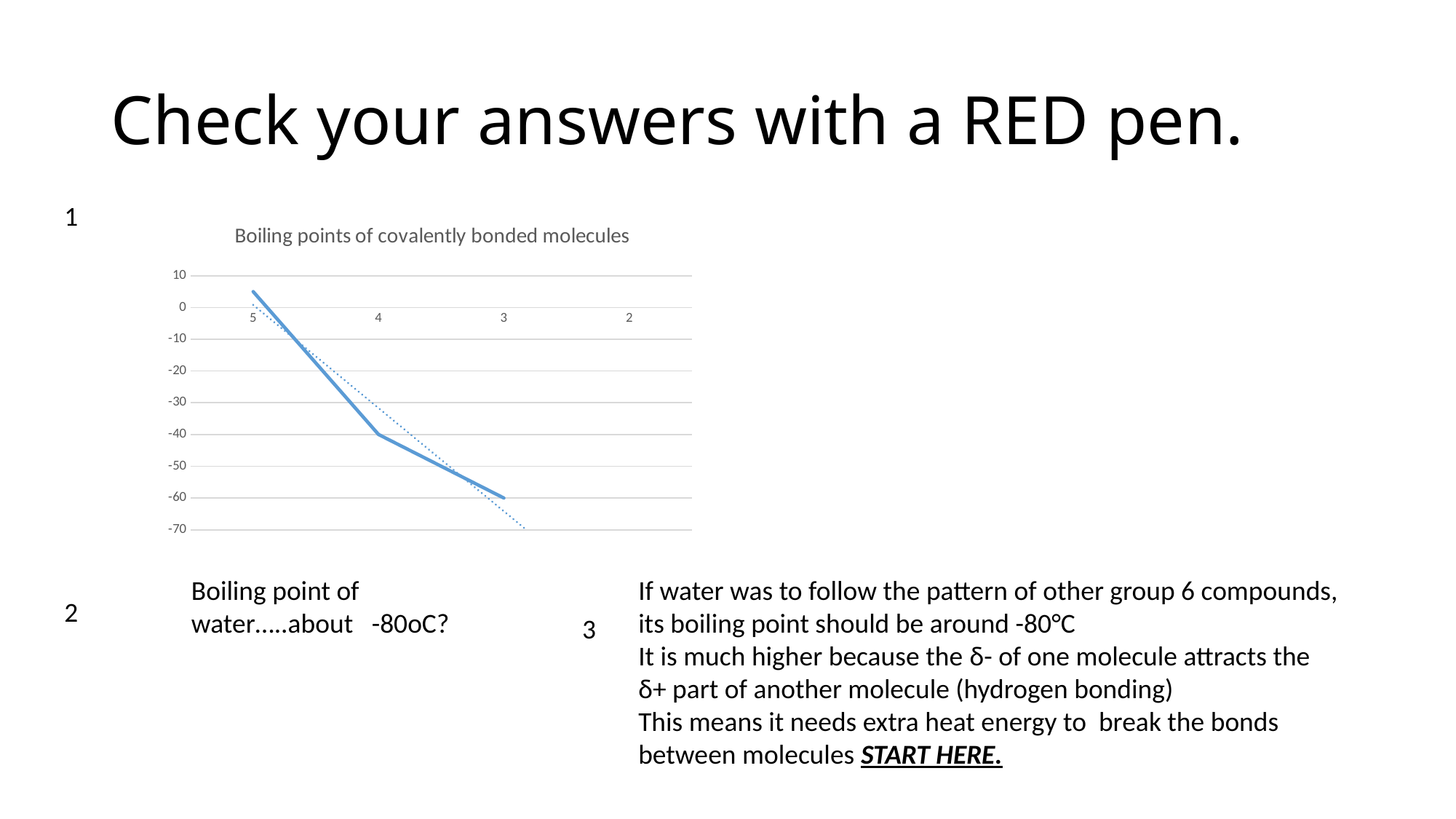
Is the plotted value for category 4 greater or less than -30? less What is the lowest value shown on the y axis of the chart? -70 What is the title of the chart? Boiling points of covalently bonded molecules Which x-axis category has the lowest plotted value? 3 Is the plotted value for category 5 greater or less than 0? greater Which x-axis category has the highest plotted value? 5 Do the plotted values rise or fall moving from category 5 to category 3 along the x axis? fall What kind of chart is shown on the slide? line chart Is the plotted value for category 3 greater or less than -50? less How many category labels are shown on the x axis of the chart? 4 Which has the larger plotted value, category 5 or category 4? 5